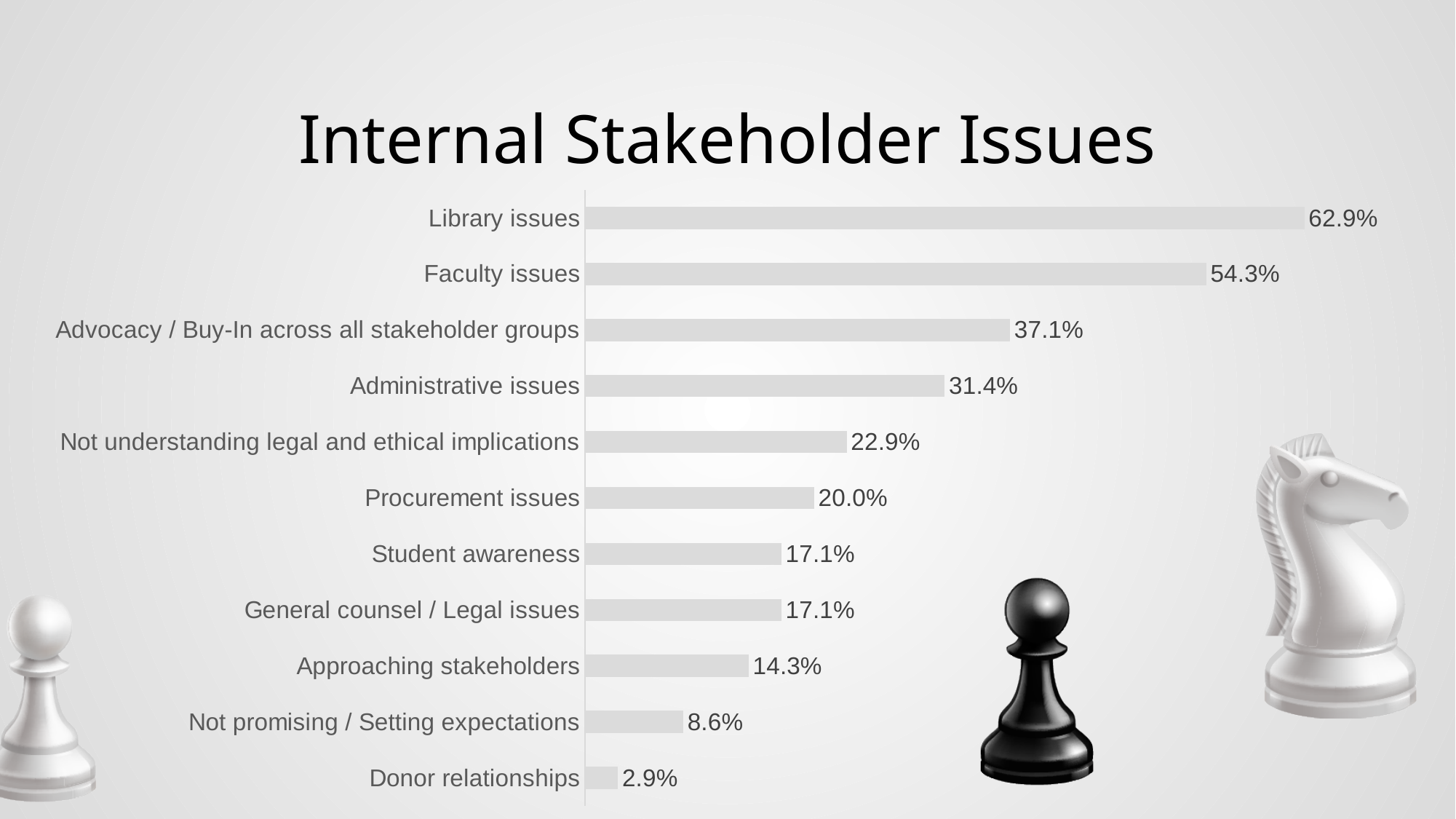
Which is larger, Approaching stakeholders or Not understanding legal and ethical implications? Not understanding legal and ethical implications What is the value for Library issues? 62.9% What is the difference between Advocacy / Buy-In across all stakeholder groups and Administrative issues? 5.7% Which category has the highest value? Library issues What kind of chart is shown on the slide? Bar chart What is the value for Administrative issues? 31.4% How many categories are shown in the chart? 11 Which is larger, Procurement issues or Student awareness? Procurement issues Which category has the lowest value? Donor relationships What is the value for Not promising / Setting expectations? 8.6% What is the difference between Library issues and Faculty issues? 8.6% What is the title of the slide? Internal Stakeholder Issues